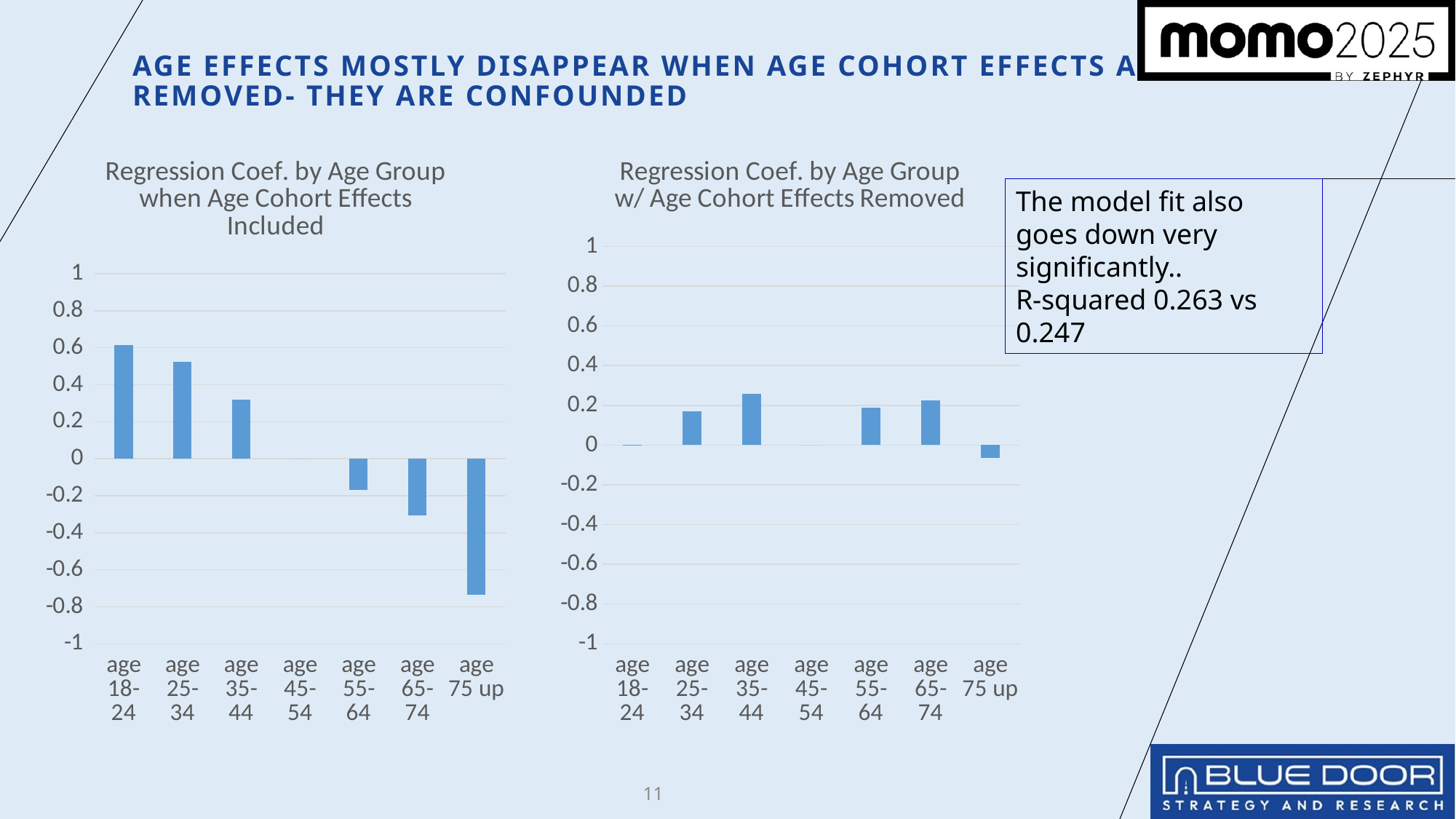
What is the title of the right chart? Regression Coef. by Age Group w/ Age Cohort Effects Removed In the left chart (Age Cohort Effects Included), do the regression coefficients rise or fall as age increases along the x axis? fall In the right chart (Age Cohort Effects Removed), which age group has the highest regression coefficient? age 35-44 In the left chart (Age Cohort Effects Included), is the value for age 75 up greater or less than -0.6? less In the left chart (Age Cohort Effects Included), which age group has the highest regression coefficient? age 18-24 In the right chart (Age Cohort Effects Removed), is the value for age 35-44 greater or less than 0.2? greater In the left chart (Age Cohort Effects Included), which is larger, the value for age 25-34 or the value for age 35-44? age 25-34 In the left chart (Age Cohort Effects Included), which age group has the lowest regression coefficient? age 75 up What kind of chart is the left chart, 'Regression Coef. by Age Group when Age Cohort Effects Included'? bar chart How many age group categories are shown on the x axis of the left chart? 7 In the right chart (Age Cohort Effects Removed), which is larger, the value for age 65-74 or the value for age 75 up? age 65-74